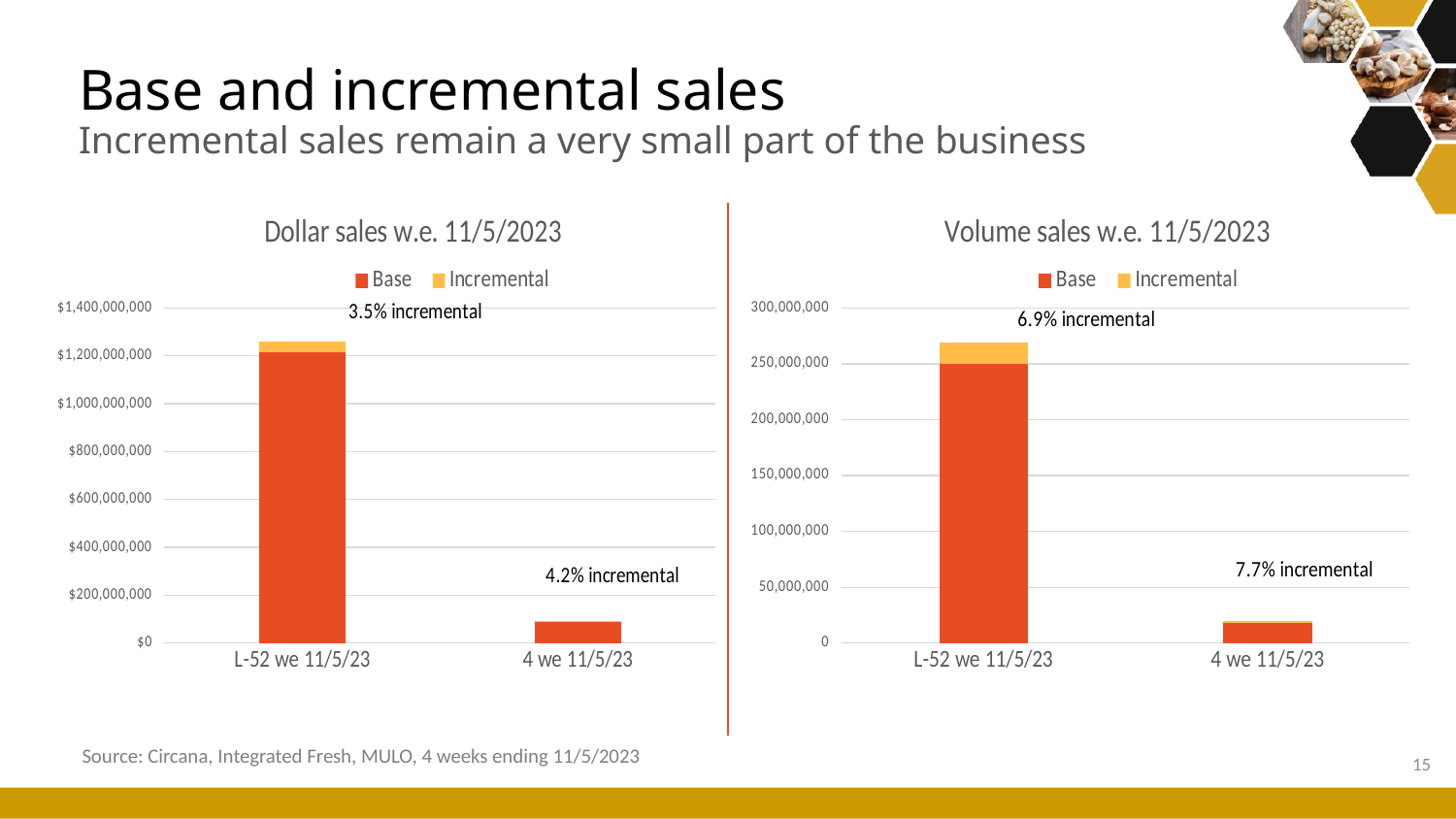
In the Dollar sales w.e. 11/5/2023 chart, is the total stacked value for 4 we 11/5/23 greater or less than $200,000,000? less In the Dollar sales w.e. 11/5/2023 chart, what percentage incremental is labelled for L-52 we 11/5/23? 3.5% incremental In the Volume sales w.e. 11/5/2023 chart, is the total stacked value for 4 we 11/5/23 greater or less than 50,000,000? less How many series does the legend of the Volume sales w.e. 11/5/2023 chart list? 2 How many categories are shown on the x axis of the Dollar sales w.e. 11/5/2023 chart? 2 In the Dollar sales w.e. 11/5/2023 chart, what percentage incremental is labelled for 4 we 11/5/23? 4.2% incremental In the Volume sales w.e. 11/5/2023 chart, what percentage incremental is labelled for L-52 we 11/5/23? 6.9% incremental In the Volume sales w.e. 11/5/2023 chart, what percentage incremental is labelled for 4 we 11/5/23? 7.7% incremental In the Volume sales w.e. 11/5/2023 chart, which category has the taller stacked bar? L-52 we 11/5/23 What kind of chart is the Dollar sales w.e. 11/5/2023 chart? Stacked bar chart In the Dollar sales w.e. 11/5/2023 chart, which category has the shorter stacked bar? 4 we 11/5/23 In the Dollar sales w.e. 11/5/2023 chart, is the total stacked value for L-52 we 11/5/23 greater or less than $1,200,000,000? greater